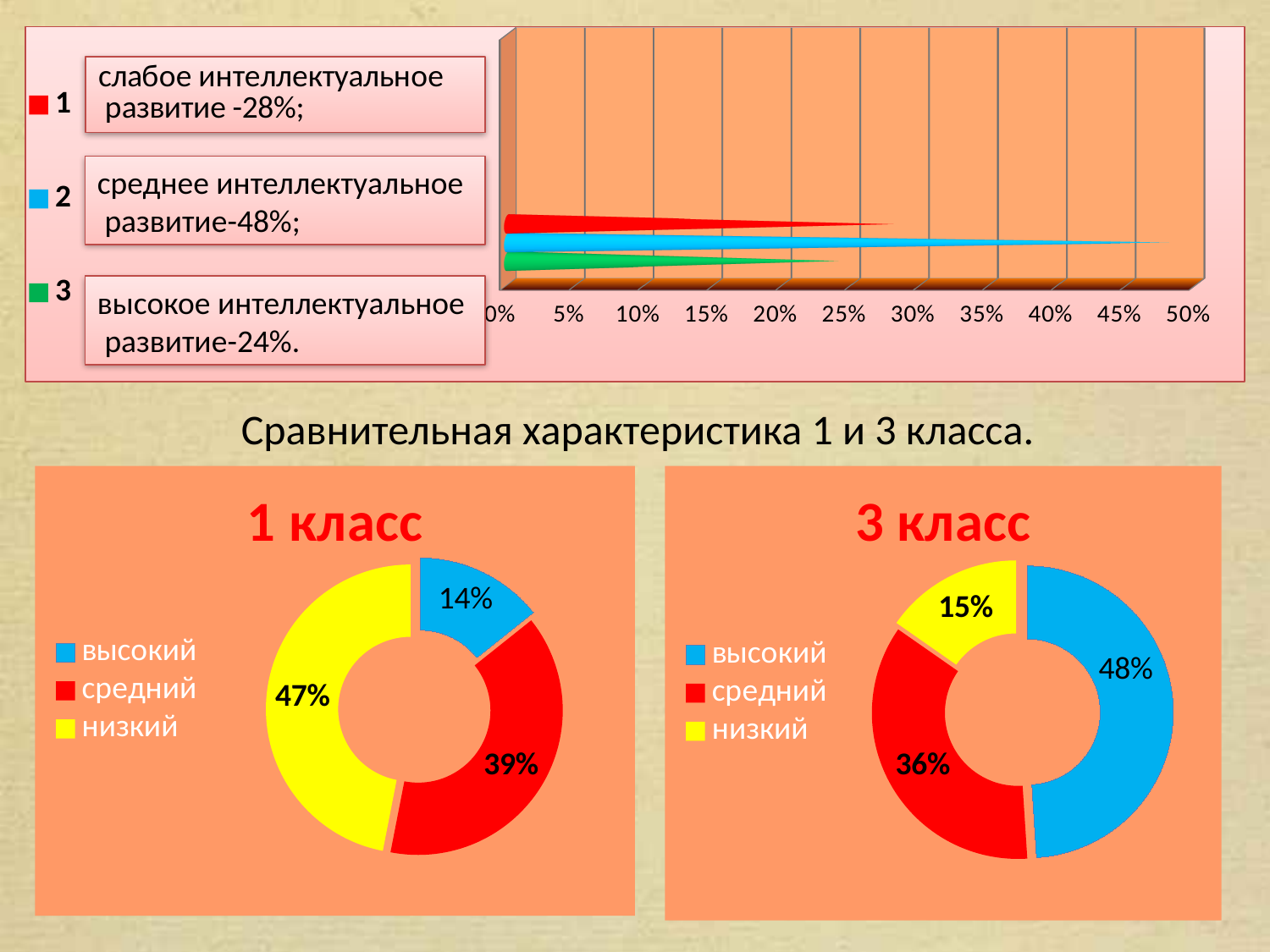
In the top bar chart, is the value for series 3 (green bar) greater or less than 25%? less What is the title printed above the two doughnut charts? Сравнительная характеристика 1 и 3 класса. In the '1 класс' doughnut chart, which category has the largest share? низкий In the '3 класс' doughnut chart, what share is labelled for средний? 36% In the top bar chart, how many series does the legend list? 3 In the top bar chart, what value is given for series 1 (слабое интеллектуальное развитие)? 28% In the '3 класс' doughnut chart, which category has the smallest share? низкий What kind of chart is the top chart on the slide? bar chart In the '1 класс' doughnut chart, what share is labelled for высокий? 14% What is the difference between the высокий share in the '3 класс' chart (48%) and the высокий share in the '1 класс' chart (14%)? 34% In the top bar chart, what value is given for series 2 (среднее интеллектуальное развитие)? 48% In the top bar chart, which series has the longest bar? 2